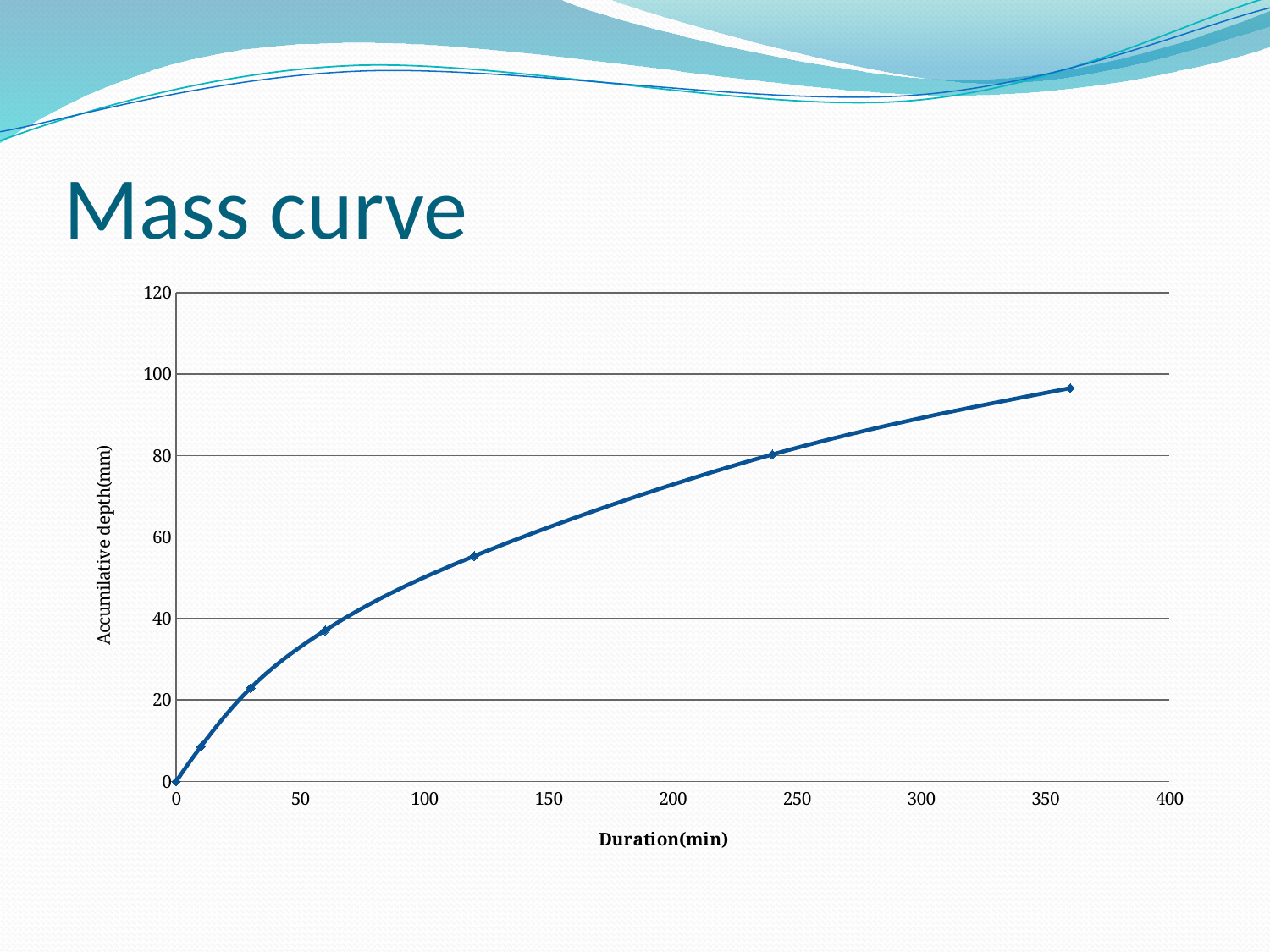
What is the accumulative depth at a duration of 0 min? 0 Is the accumulative depth at 240 min greater or less than 100 mm? less How many data points are marked on the curve? 7 At which duration is the accumulative depth highest? 360 min Is the accumulative depth at 30 min greater or less than 20 mm? greater What kind of chart is shown on the slide? line chart Is the accumulative depth at 120 min greater or less than 60 mm? less What is the label of the horizontal axis? Duration(min) Does the accumulative depth rise or fall as duration increases? rises What is the label of the vertical axis? Accumilative depth(mm)